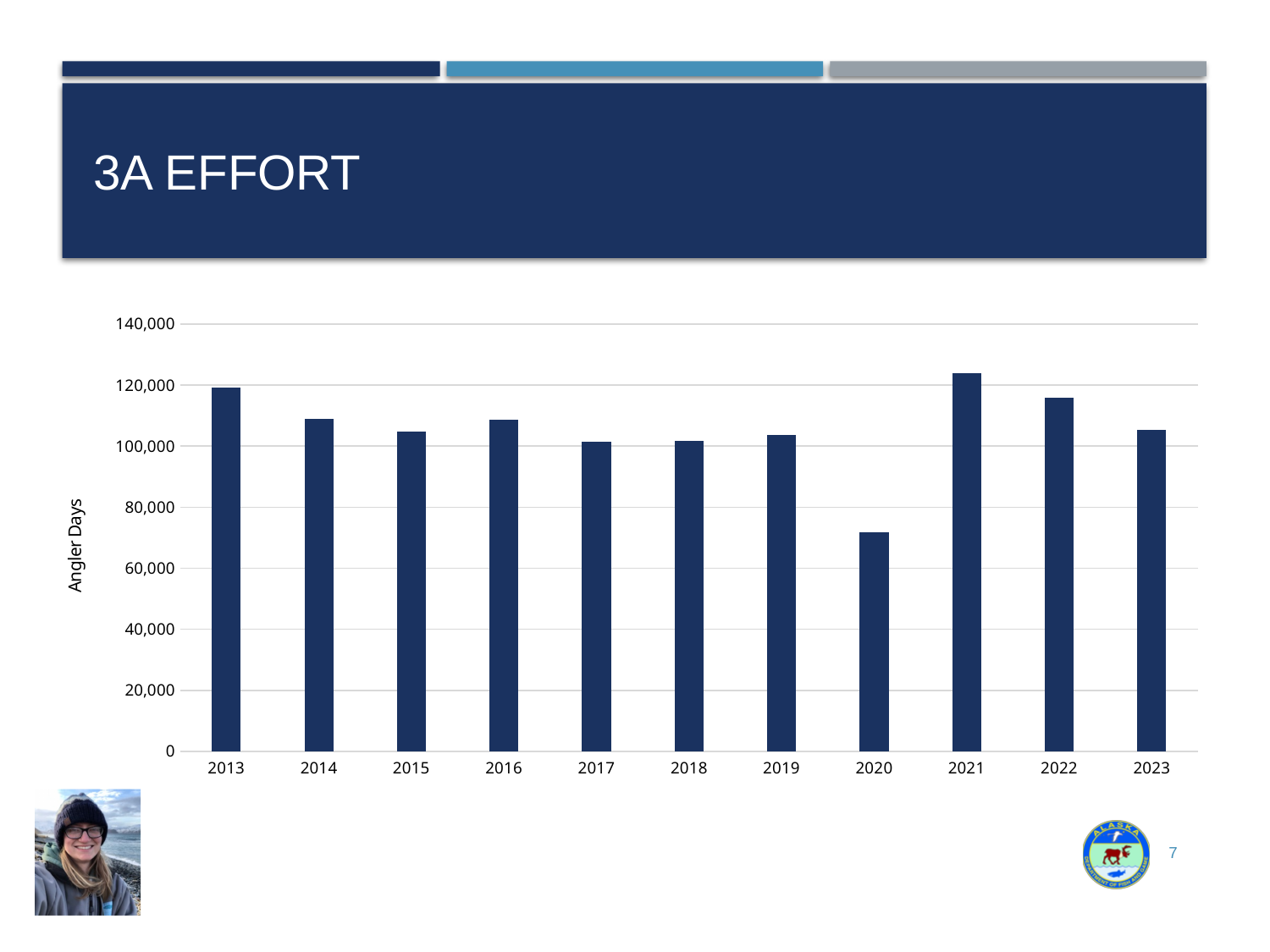
What kind of chart is shown on the slide? Bar chart What is the label on the y axis of the chart? Angler Days Is the value for 2022 greater or less than 100,000? greater Which year has the highest number of angler days? 2021 How many years are shown on the x axis of the chart? 11 Do the values rise or fall from 2021 to 2023? fall Is the value for 2020 greater or less than 80,000? less Which year has the lowest number of angler days? 2020 Is the value for 2021 greater or less than 120,000? greater Which year has more angler days, 2019 or 2020? 2019 Which year has more angler days, 2013 or 2014? 2013